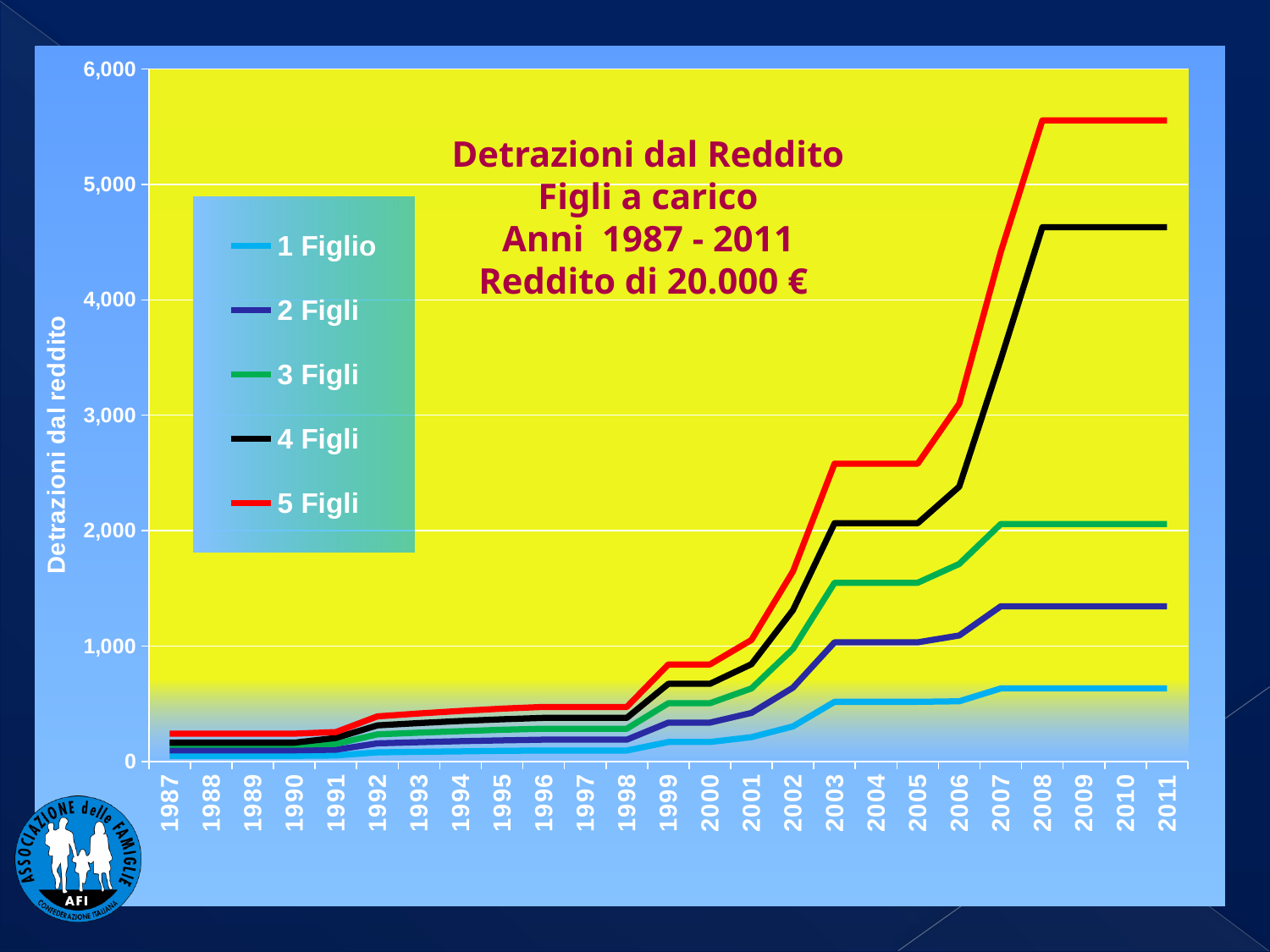
Is the value for 5 Figli in 2011 greater or less than 5,000? greater Is the value for 4 Figli in 2011 greater or less than 4,000? greater How many years are shown along the x axis? 25 Is the value for 5 Figli in 2003 greater or less than 2,000? greater Which series has the lowest value in 2011? 1 Figlio Which series has the highest value in 2011? 5 Figli Do the values for 5 Figli generally rise or fall from 1987 to 2011? rise Which is larger in 2007, the value for 2 Figli or the value for 1 Figlio? 2 Figli What colour is the line for 5 Figli? red What kind of chart is shown on the slide? line chart How many series does the legend list? 5